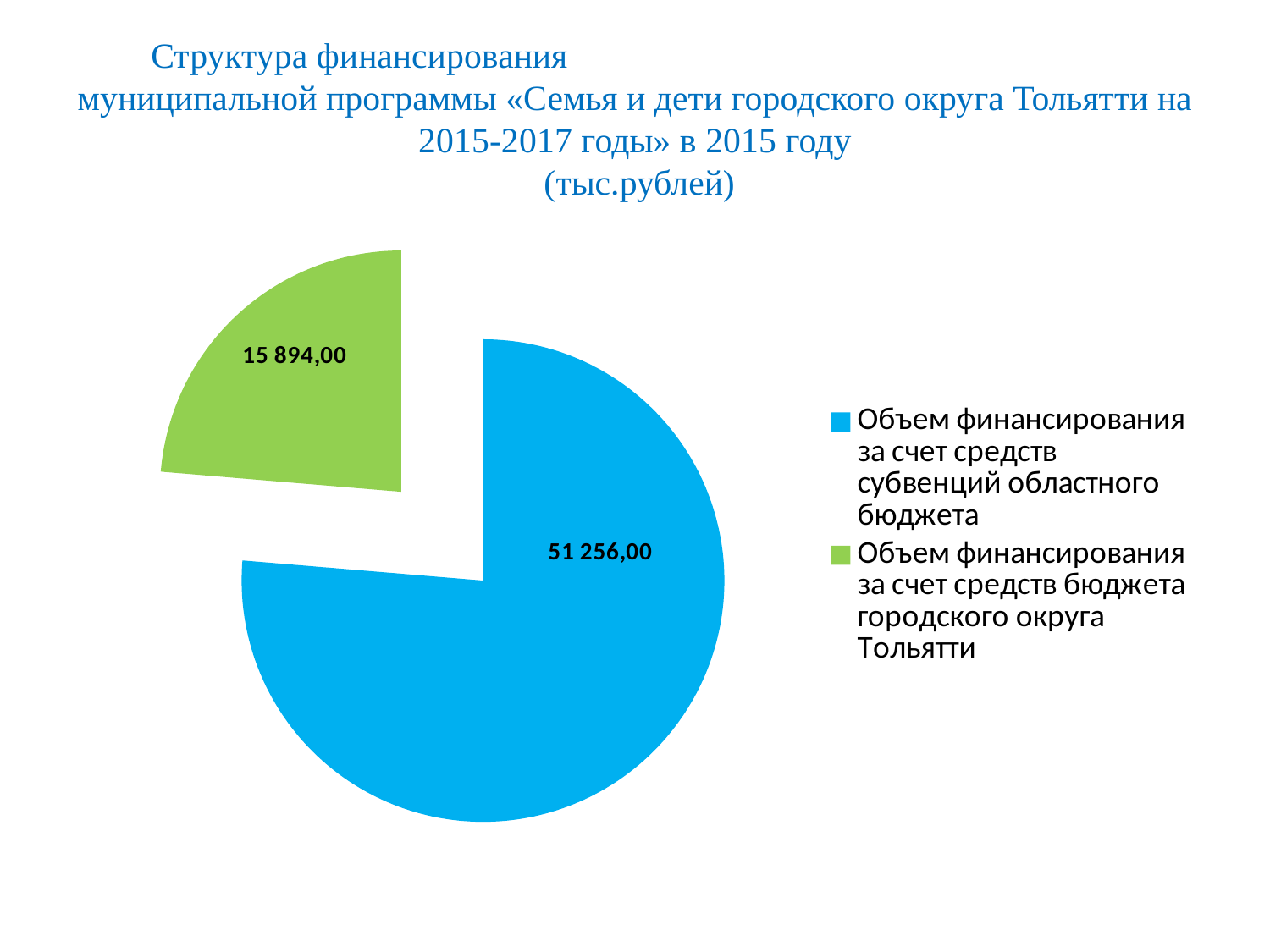
What is the value for «Объем финансирования за счет средств бюджета городского округа Тольятти»? 15 894,00 How many slices does the pie chart have? 2 How many entries does the legend list? 2 Which funding source has the smallest slice of the pie? Объем финансирования за счет средств бюджета городского округа Тольятти What is the difference between the regional budget subventions (51 256,00) and the city budget funding (15 894,00)? 35 362,00 Which funding source has the largest slice of the pie? Объем финансирования за счет средств субвенций областного бюджета What share of the total does the city budget slice (15 894,00) represent, to one decimal place? 23.7% What is the total funding shown across both slices of the pie? 67 150,00 What type of chart is shown on the slide? pie chart What colour is the slice for «Объем финансирования за счет средств бюджета городского округа Тольятти»? green What is the value for «Объем финансирования за счет средств субвенций областного бюджета»? 51 256,00 Which is larger: funding from regional budget subventions or funding from the Tolyatti city budget? funding from regional budget subventions